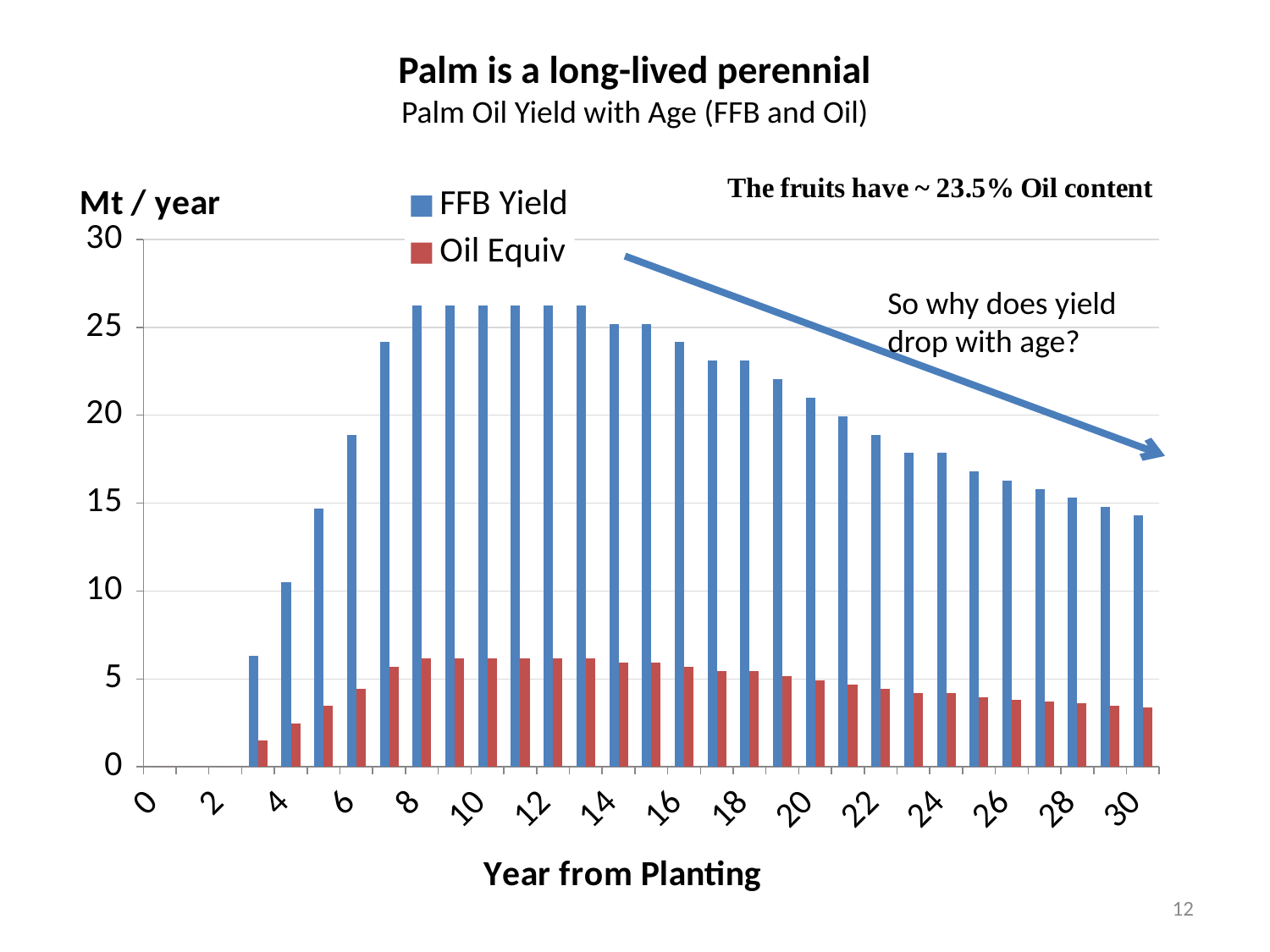
Is the FFB Yield value at year 30 greater or less than 15? less Does the FFB Yield rise or fall from year 14 to year 30? Fall Is the FFB Yield value at year 10 greater or less than 25? greater How many series does the legend list? 2 Is the Oil Equiv value at year 8 greater or less than 5? greater What are the two series named in the legend? FFB Yield and Oil Equiv What is the title of the x axis? Year from Planting What kind of chart is shown on the slide? Bar chart Which is larger, the FFB Yield at year 8 or the FFB Yield at year 30? Year 8 Which series has the higher values throughout the chart, FFB Yield or Oil Equiv? FFB Yield